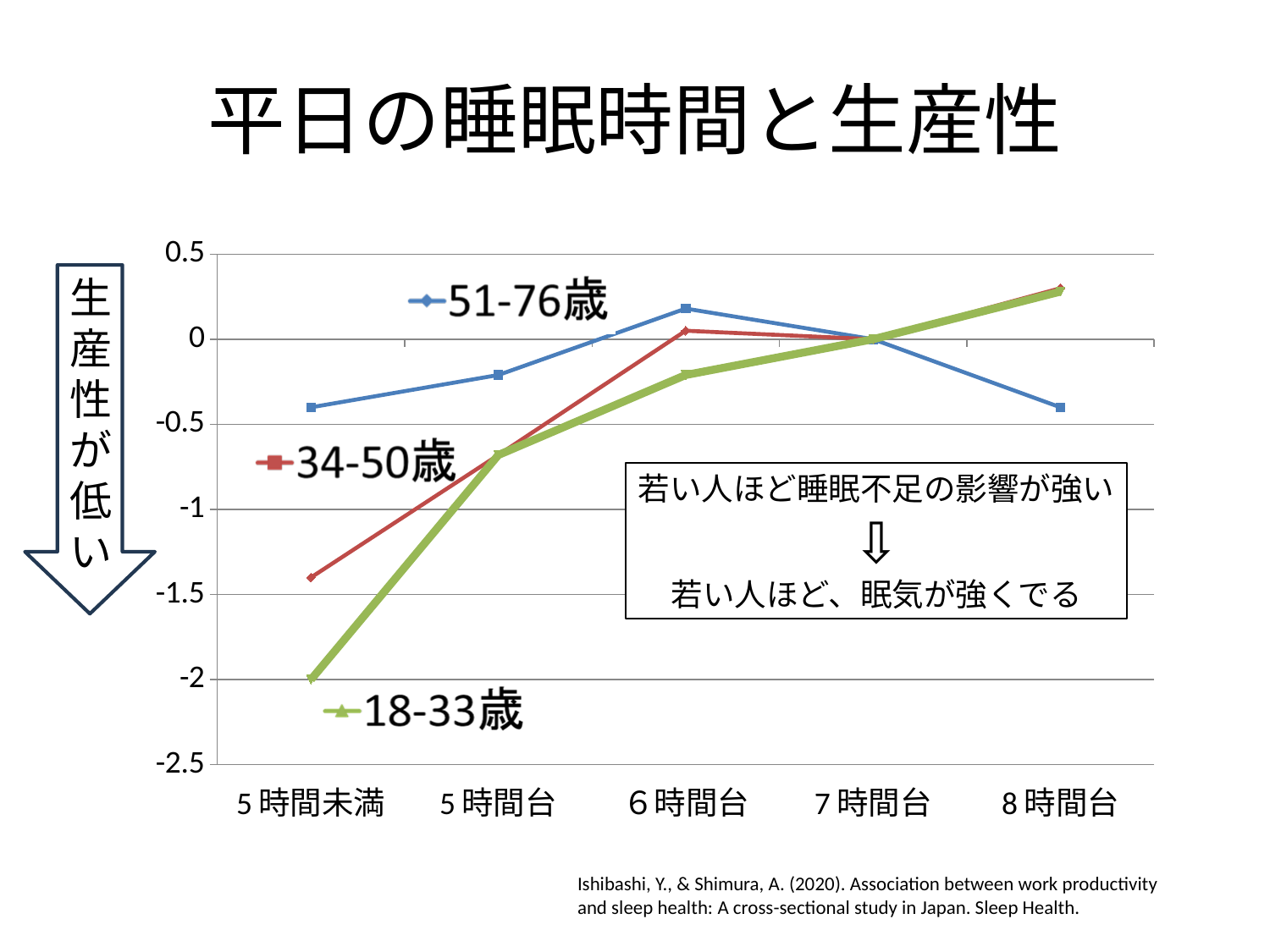
Is the value for 34-50歳 at 5時間未満 greater or less than -1? less Which age group has the lowest value at 8時間台? 51-76歳 Is the value for 18-33歳 at 8時間台 greater or less than 0? greater How many age-group series are plotted in the chart? 3 What kind of chart is shown on the slide? line chart Which age group has the highest value at 6時間台? 51-76歳 Which is larger at 5時間未満: the value for 51-76歳 or the value for 34-50歳? 51-76歳 Does the 18-33歳 line rise or fall as sleep duration increases from 5時間未満 to 8時間台? rise How many sleep-duration categories are shown on the x axis? 5 What is the title of the chart on the slide? 平日の睡眠時間と生産性 Which age group has the lowest value at 5時間未満? 18-33歳 Is the value for 51-76歳 at 5時間未満 greater or less than -0.5? greater